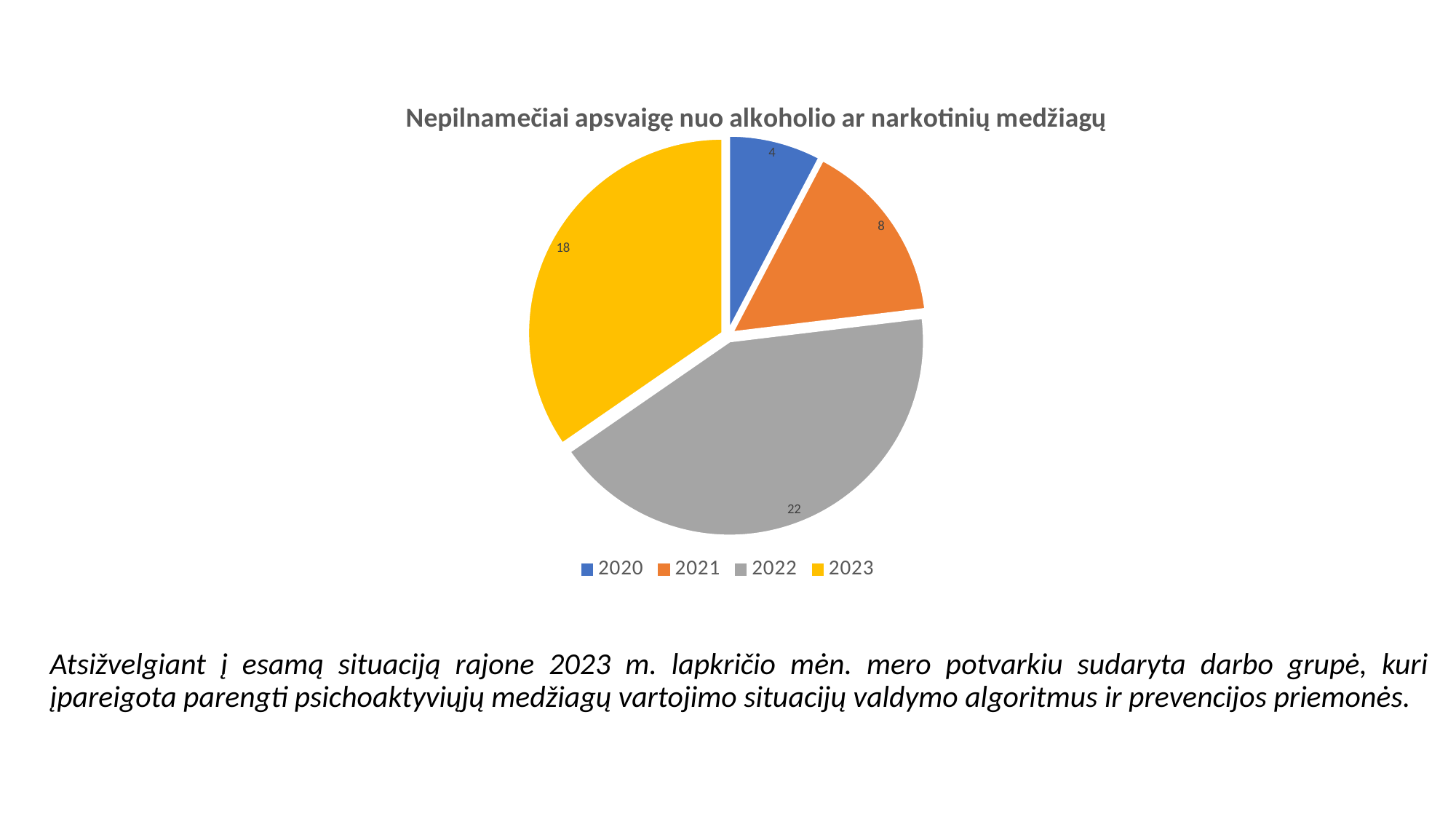
What is the title of the chart? Nepilnamečiai apsvaigę nuo alkoholio ar narkotinių medžiagų Which is larger, the value for 2021 or the value for 2023? 2023 What is the value for 2021 in the pie chart? 8 Which year has the largest slice in the pie chart? 2022 What is the difference between the values for 2022 and 2023? 4 Which year has the smallest slice in the pie chart? 2020 What type of chart is shown on the slide? pie chart What is the value for 2020 in the pie chart? 4 What colour is the slice for 2023? yellow What is the value for 2022 in the pie chart? 22 How many years does the legend list? 4 What is the value for 2023 in the pie chart? 18